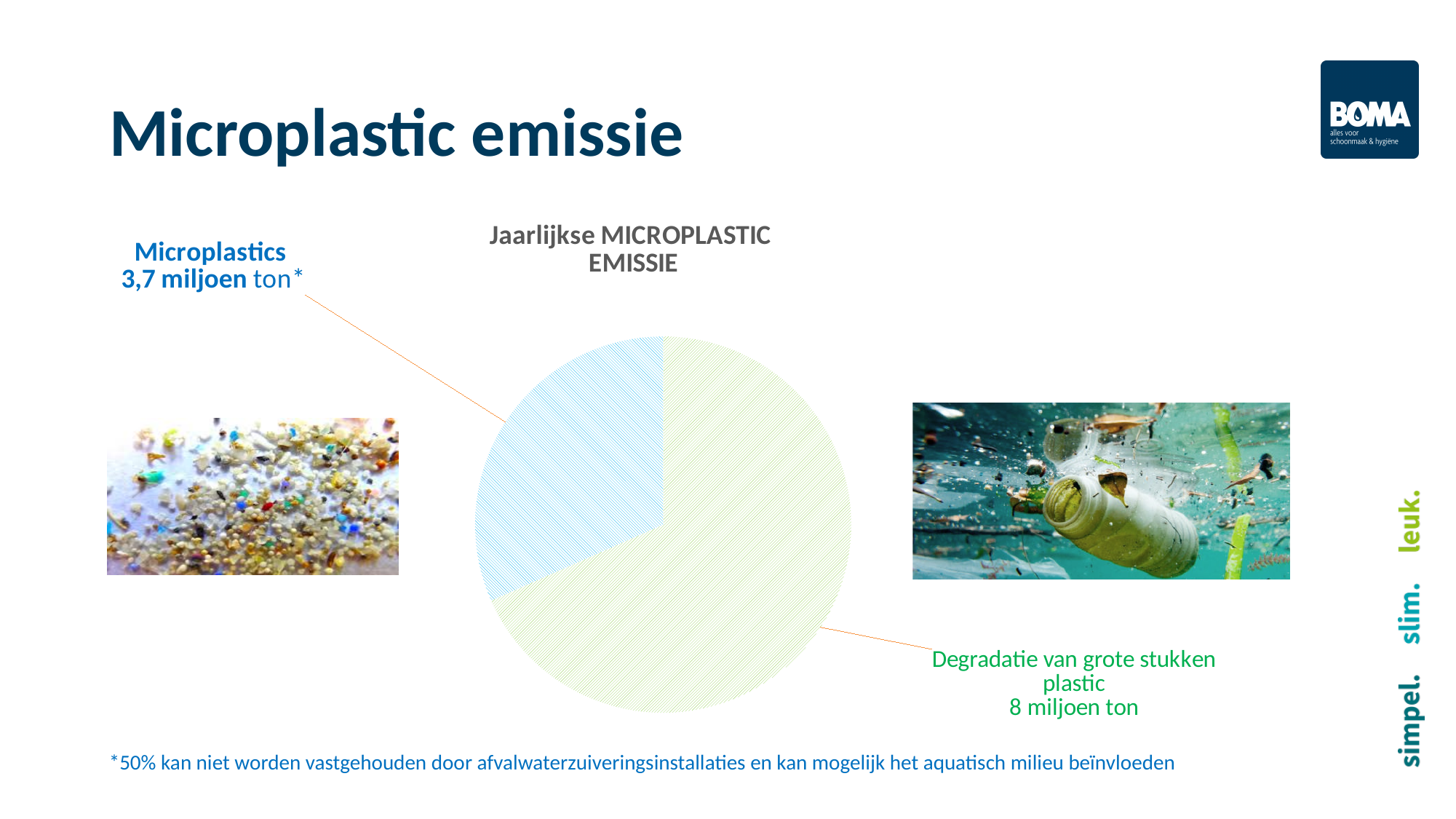
What is the total of the two slices in the pie chart? 11,7 miljoen ton What kind of chart is shown on the slide? pie chart What is the title of the pie chart? Jaarlijkse MICROPLASTIC EMISSIE Which slice of the pie chart is the largest? Degradatie van grote stukken plastic How many slices does the pie chart have? 2 What is the difference between Degradatie van grote stukken plastic and Microplastics? 4,3 miljoen ton What is the value for Microplastics in the pie chart? 3,7 miljoen ton Which is larger: Microplastics or Degradatie van grote stukken plastic? Degradatie van grote stukken plastic Which slice of the pie chart is the smallest? Microplastics Which colour is used for the Microplastics slice in the pie chart? blue What is the value for Degradatie van grote stukken plastic in the pie chart? 8 miljoen ton